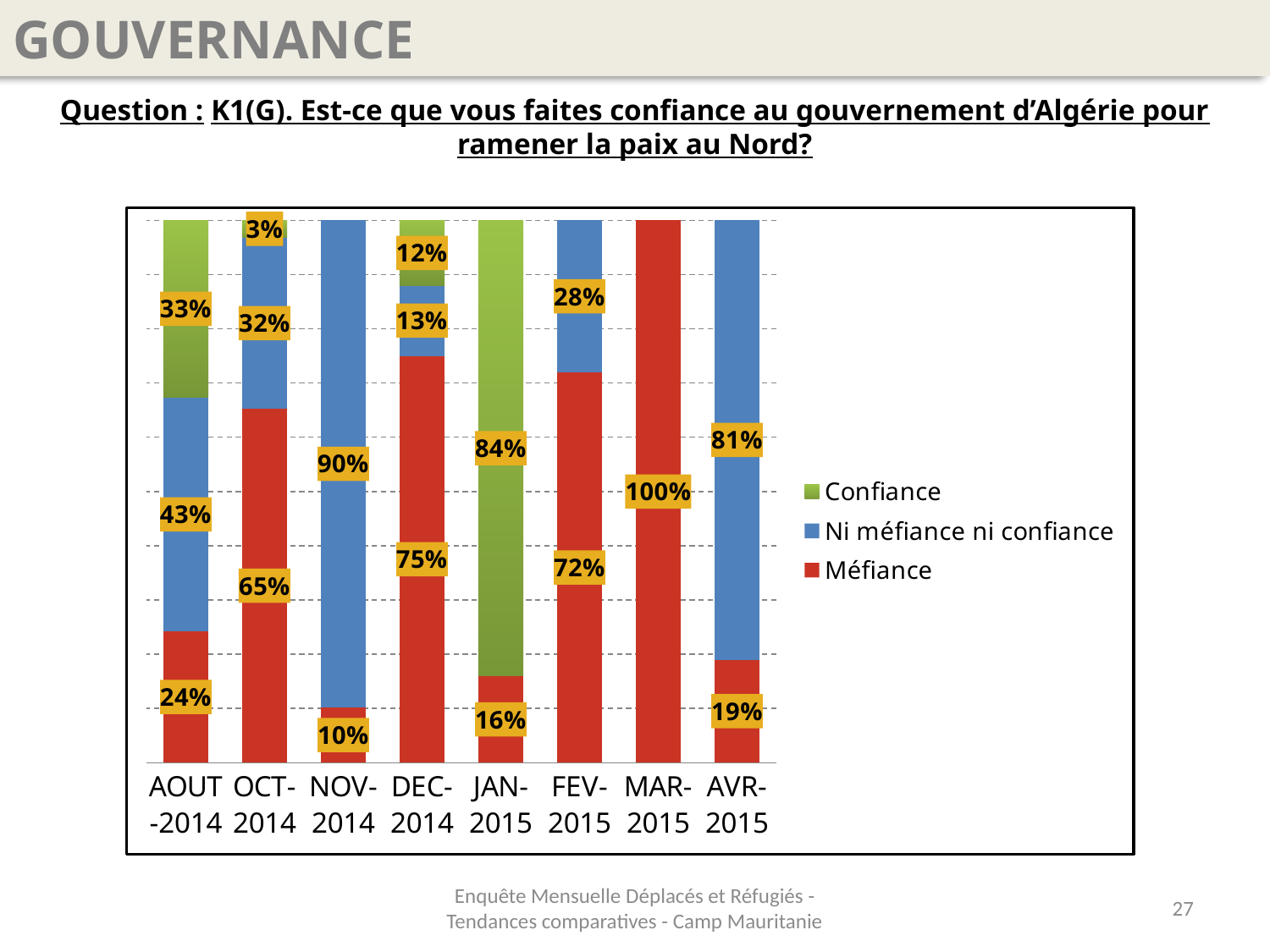
Which is larger, the Confiance value for AOUT-2014 or for DEC-2014? AOUT-2014 What is the Confiance value for OCT-2014? 3% Which month has the lowest Méfiance value? NOV-2014 How many months are shown on the x axis? 8 What kind of chart is shown on the slide? Stacked bar chart What is the Ni méfiance ni confiance value for NOV-2014? 90% Which month has the highest Confiance value? JAN-2015 What is the Confiance value for JAN-2015? 84% Which month has the highest Méfiance value? MAR-2015 How many series does the legend list? 3 What is the difference between the Méfiance value for DEC-2014 and the Méfiance value for FEV-2015? 3 percentage points What is the Méfiance value for AOUT-2014? 24%